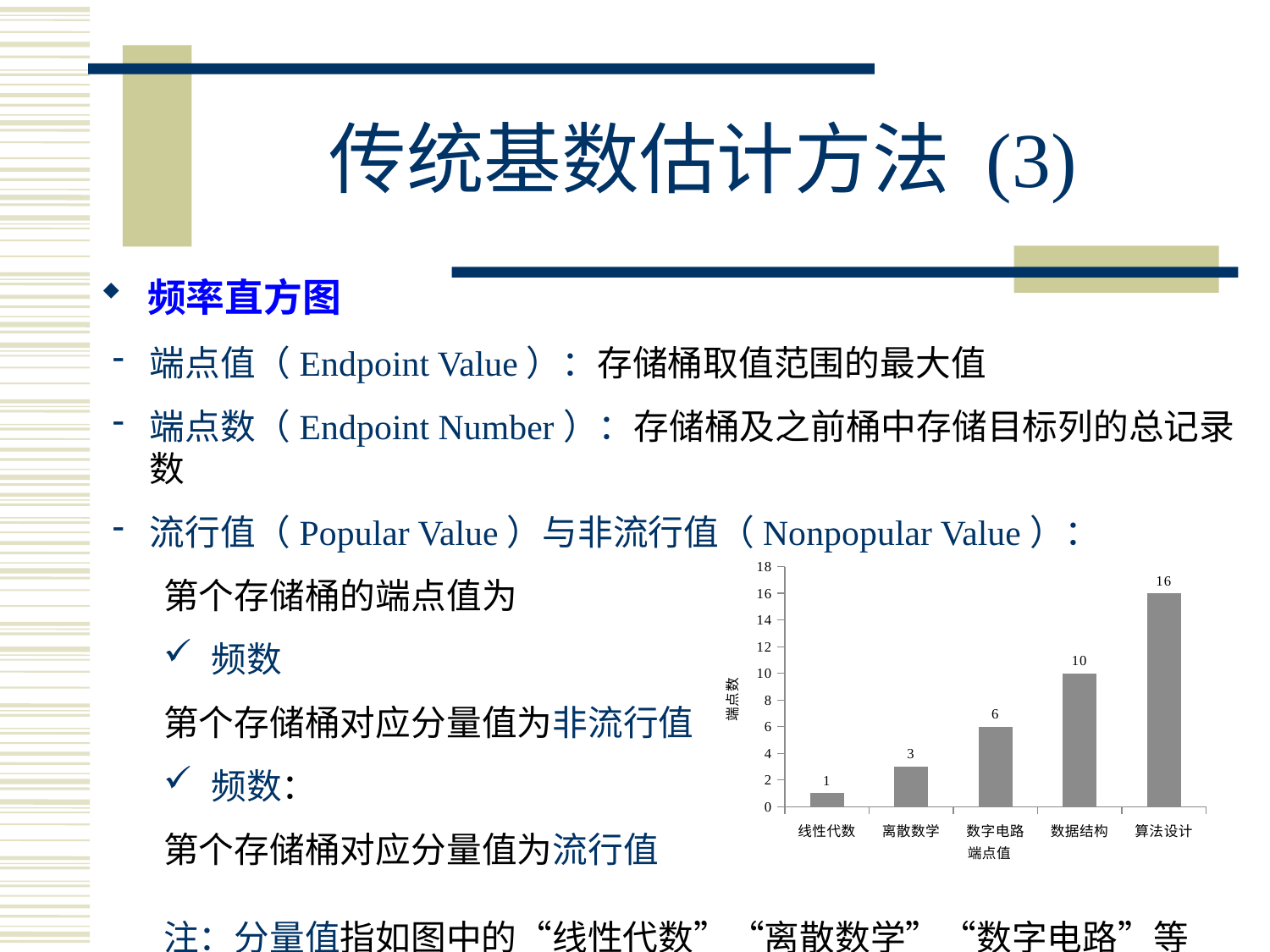
Which category has the highest value in the chart? 算法设计 Is the value for 算法设计 greater or less than 14? greater What is the value for 数字电路 in the chart? 6 What is the value for 数据结构 in the chart? 10 Which category has the lowest value in the chart? 线性代数 What is the label of the y axis of the chart? 端点数 How many categories are shown on the x axis of the chart? 5 Which is larger, the value for 离散数学 or the value for 数字电路? 数字电路 What kind of chart is shown on the slide? bar chart What is the value for 线性代数 in the chart? 1 Do the values rise or fall from left to right along the x axis? rise What is the difference between the values for 算法设计 and 数据结构? 6